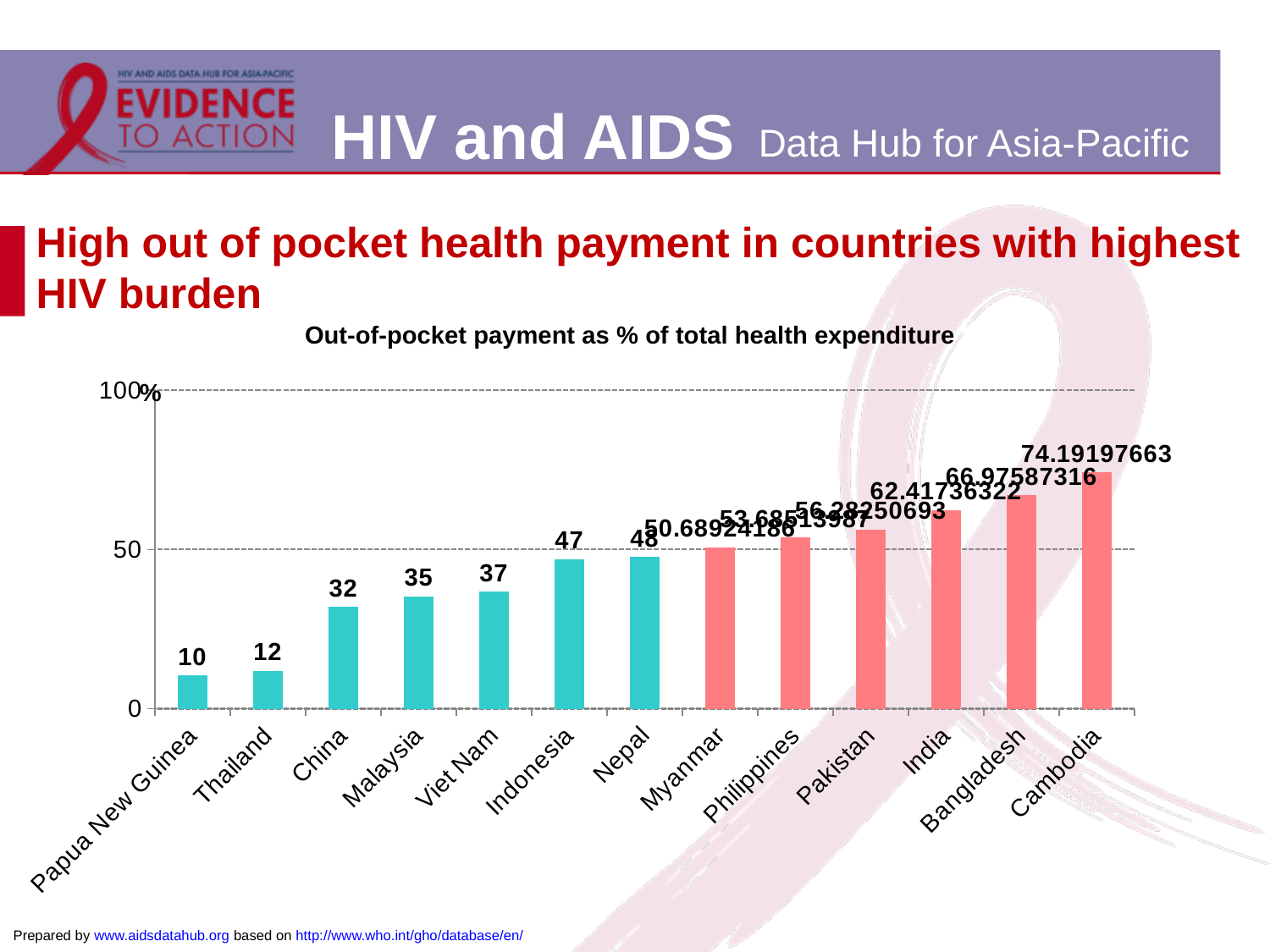
What is the difference between the values for Viet Nam and Thailand? 25 Which country has the lowest out-of-pocket payment share? Papua New Guinea How many countries are shown in the chart? 13 Which country has the highest out-of-pocket payment share? Cambodia What kind of chart is shown on the slide? Bar chart Is the value for Philippines greater or less than 50? greater What is the value for India? 62.41736322 What is the value for Cambodia? 74.19197663 What is the value for China? 32 Which is larger, the value for Malaysia or the value for Nepal? Nepal What is the title of the chart? Out-of-pocket payment as % of total health expenditure What is the value for Indonesia? 47